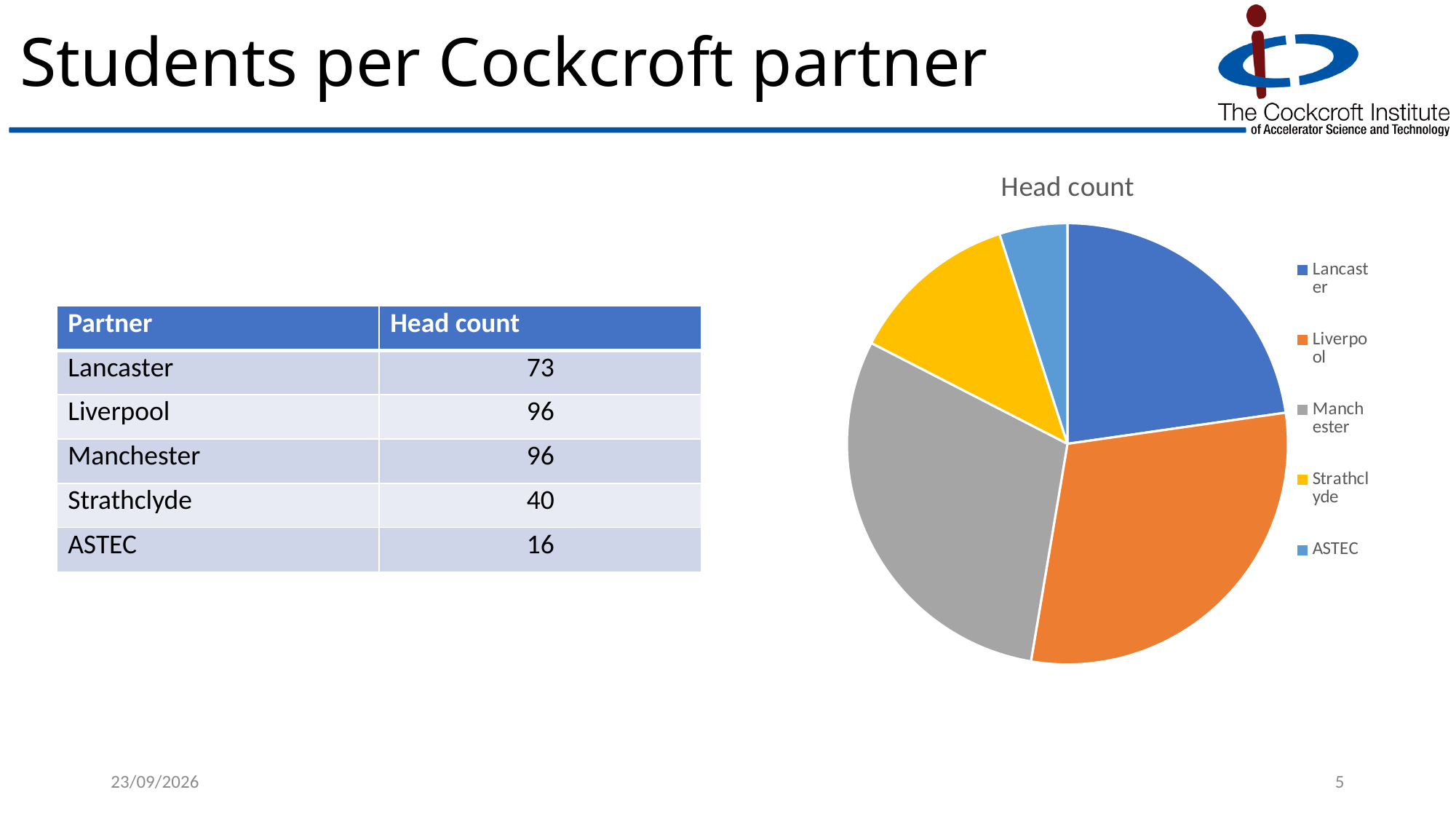
What is the title of the chart? Head count What kind of chart is shown on the slide? pie chart What is the head count for Manchester? 96 What is the total head count across all five partners in the pie chart? 321 Which partner has the smallest head count? ASTEC How many partners (slices) does the pie chart show? 5 What is the difference in head count between Liverpool and Lancaster? 23 What is the difference in head count between Strathclyde and ASTEC? 24 Which has the larger head count, Lancaster or Strathclyde? Lancaster What is the head count for Strathclyde? 40 What is the head count for Lancaster? 73 What is the head count for ASTEC? 16